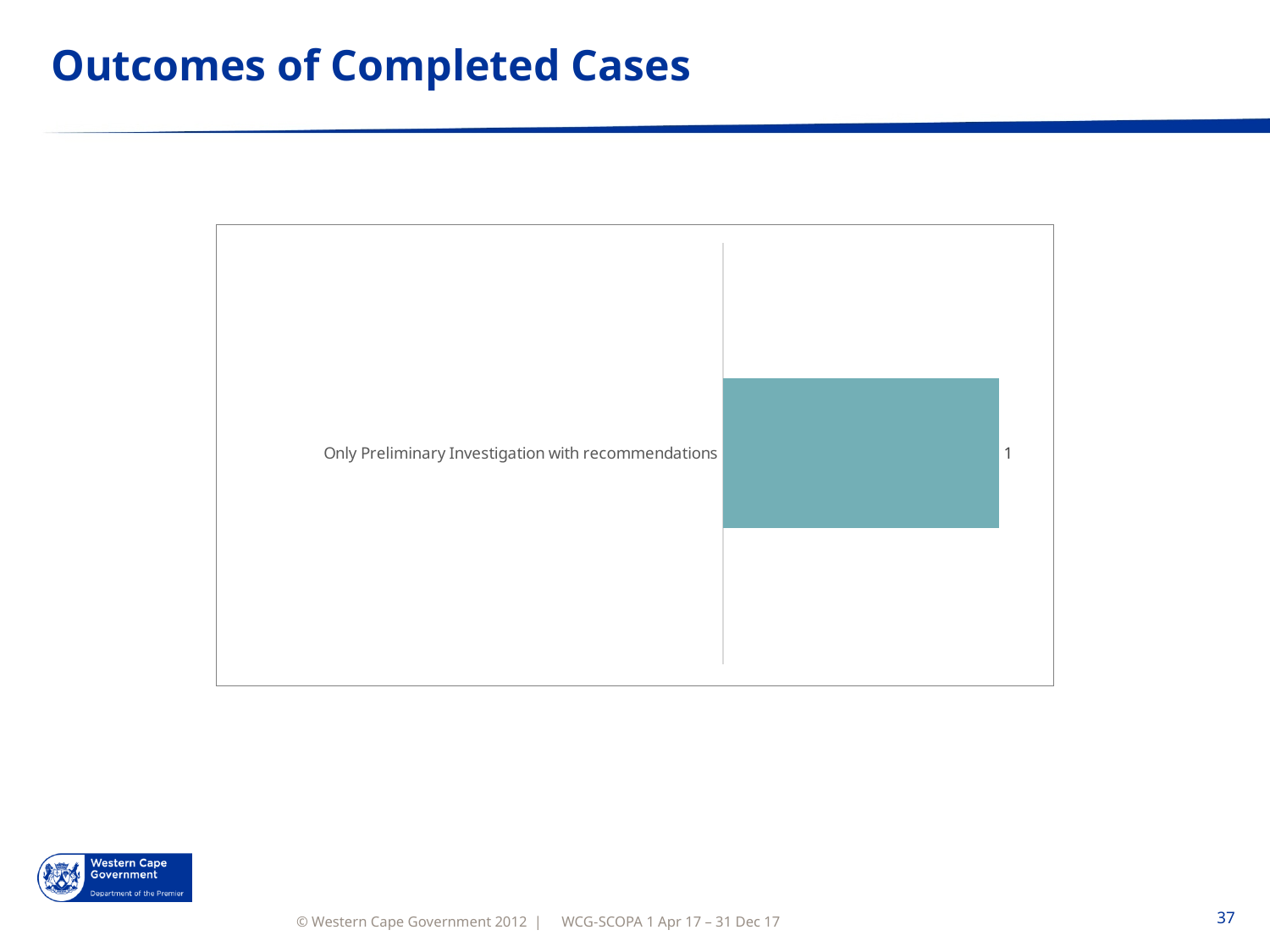
What kind of chart is shown on the slide? bar chart What is the title of the slide containing the chart? Outcomes of Completed Cases What is the value for "Only Preliminary Investigation with recommendations"? 1 What is the label of the only category shown in the chart? Only Preliminary Investigation with recommendations Are the bars in the chart horizontal or vertical? horizontal How many categories are plotted in the chart? 1